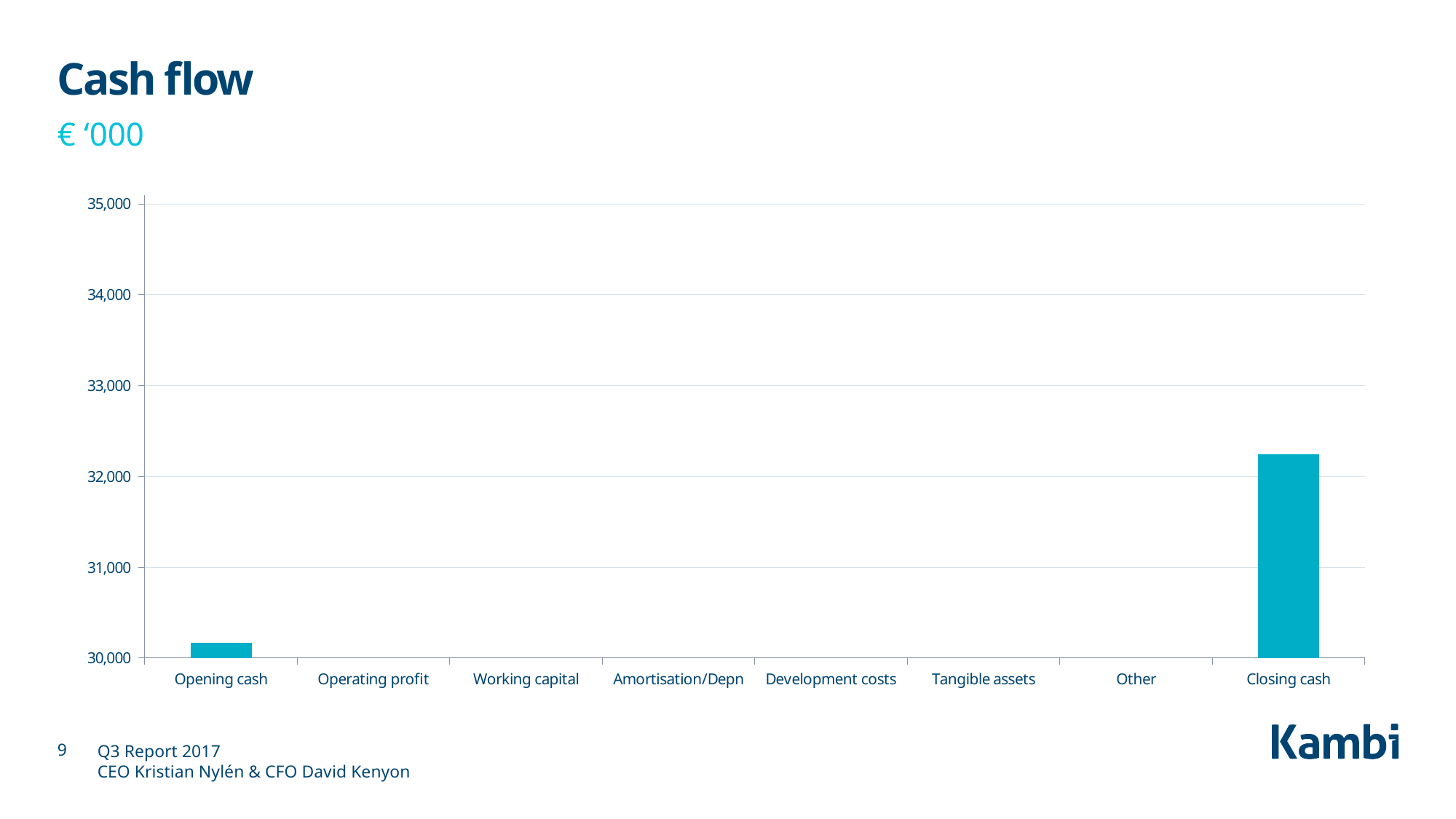
Which is larger, the value for Closing cash or the value for Opening cash? Closing cash Is the value for Opening cash greater or less than 31,000? less What is the title of the chart on the slide? Cash flow Is the value for Closing cash greater or less than 32,000? greater What unit is stated for the values in the chart? € '000 Is the value for Closing cash greater or less than 33,000? less Which category has the tallest bar in the chart? Closing cash What kind of chart is shown on the slide? bar chart How many categories are listed along the x axis of the chart? 8